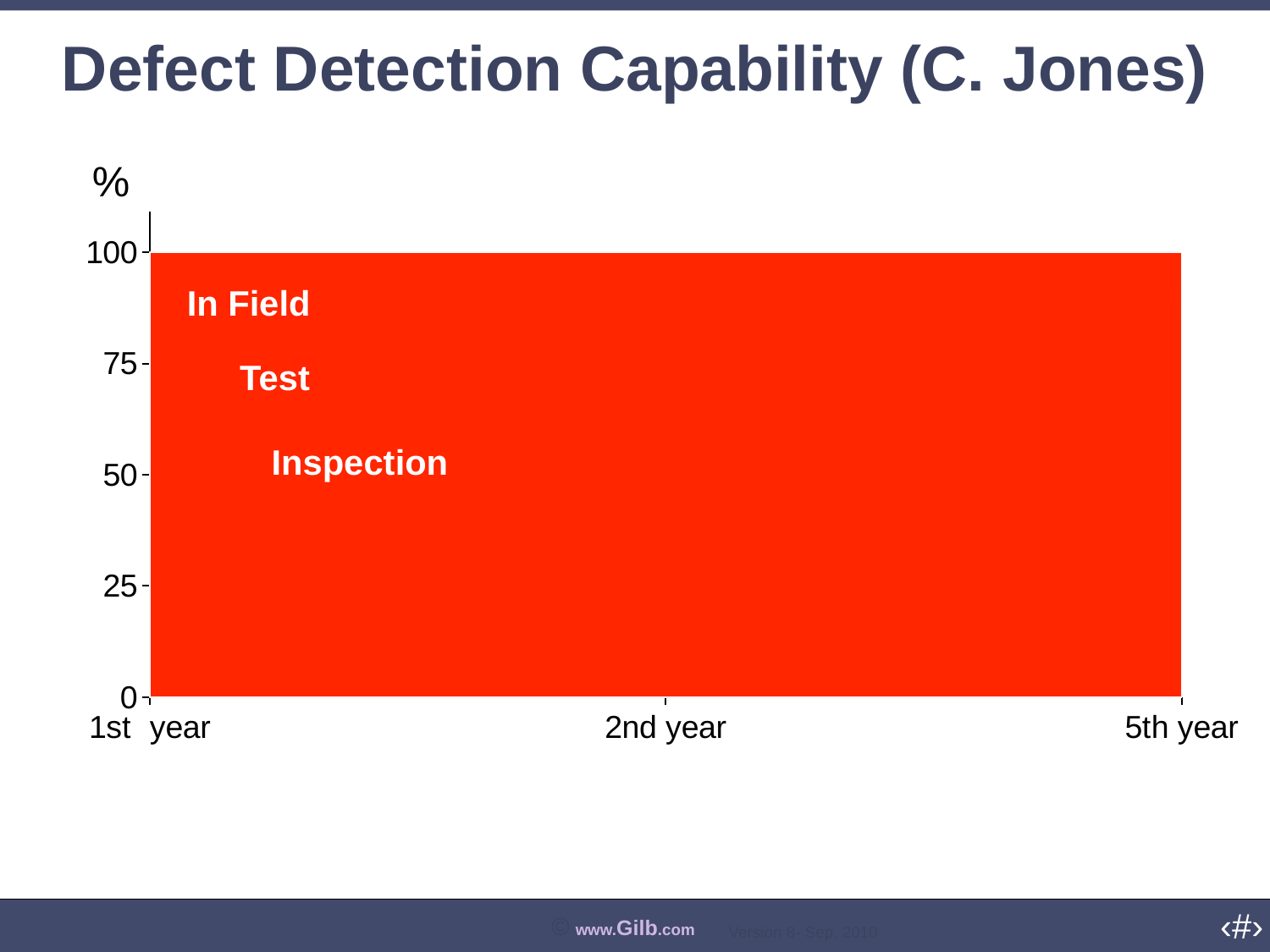
What is the first label on the x axis of the chart? 1st year How many labelled points are there on the x axis of the chart? 3 What is the last label on the x axis of the chart? 5th year What is the total height of the plotted area at 1st year, as read against the y axis? 100 Which series label appears at the top of the chart area? In Field What is the highest value marked on the y axis of the chart? 100 Which series label appears lowest in the chart area? Inspection How many series labels (In Field, Test, Inspection) are shown inside the chart area? 3 What is the total height of the plotted area at 5th year, as read against the y axis? 100 Is the top of the plotted area at 2nd year greater or less than 75? greater What is the title of the chart? Defect Detection Capability (C. Jones) What unit is shown on the y axis of the chart? %